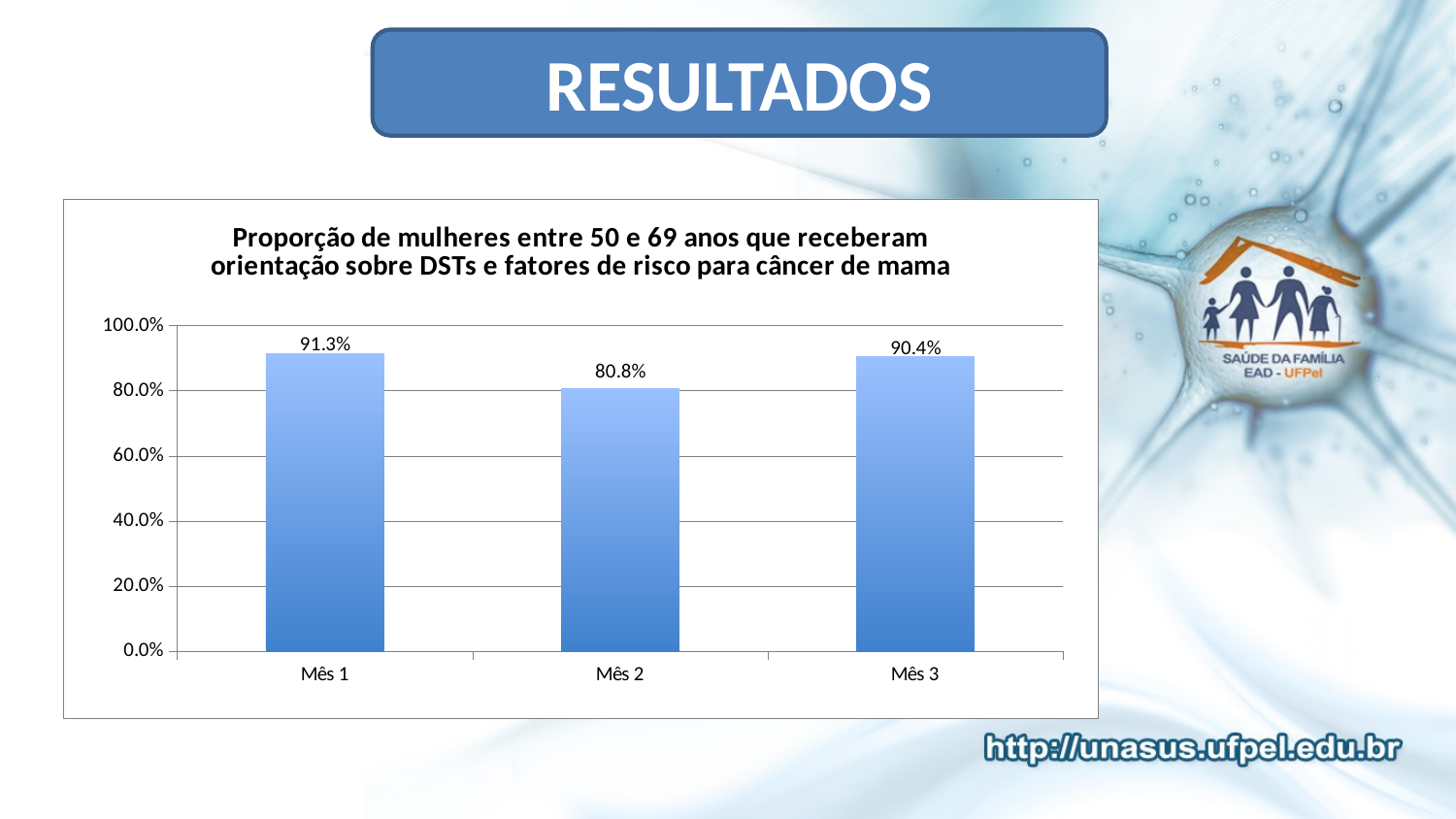
What kind of chart is shown on the slide? Bar chart What is the value for Mês 1? 91.3% What is the difference between the values for Mês 3 and Mês 2? 9.6% Which month has the lowest value? Mês 2 Which is larger, the value for Mês 2 or the value for Mês 3? Mês 3 What is the value for Mês 2? 80.8% What is the difference between the values for Mês 1 and Mês 2? 10.5% Which month has the highest value? Mês 1 What is the title of the chart? Proporção de mulheres entre 50 e 69 anos que receberam orientação sobre DSTs e fatores de risco para câncer de mama What is the value for Mês 3? 90.4% How many months are shown on the x axis? 3 Is the value for Mês 2 greater or less than 80.0%? greater